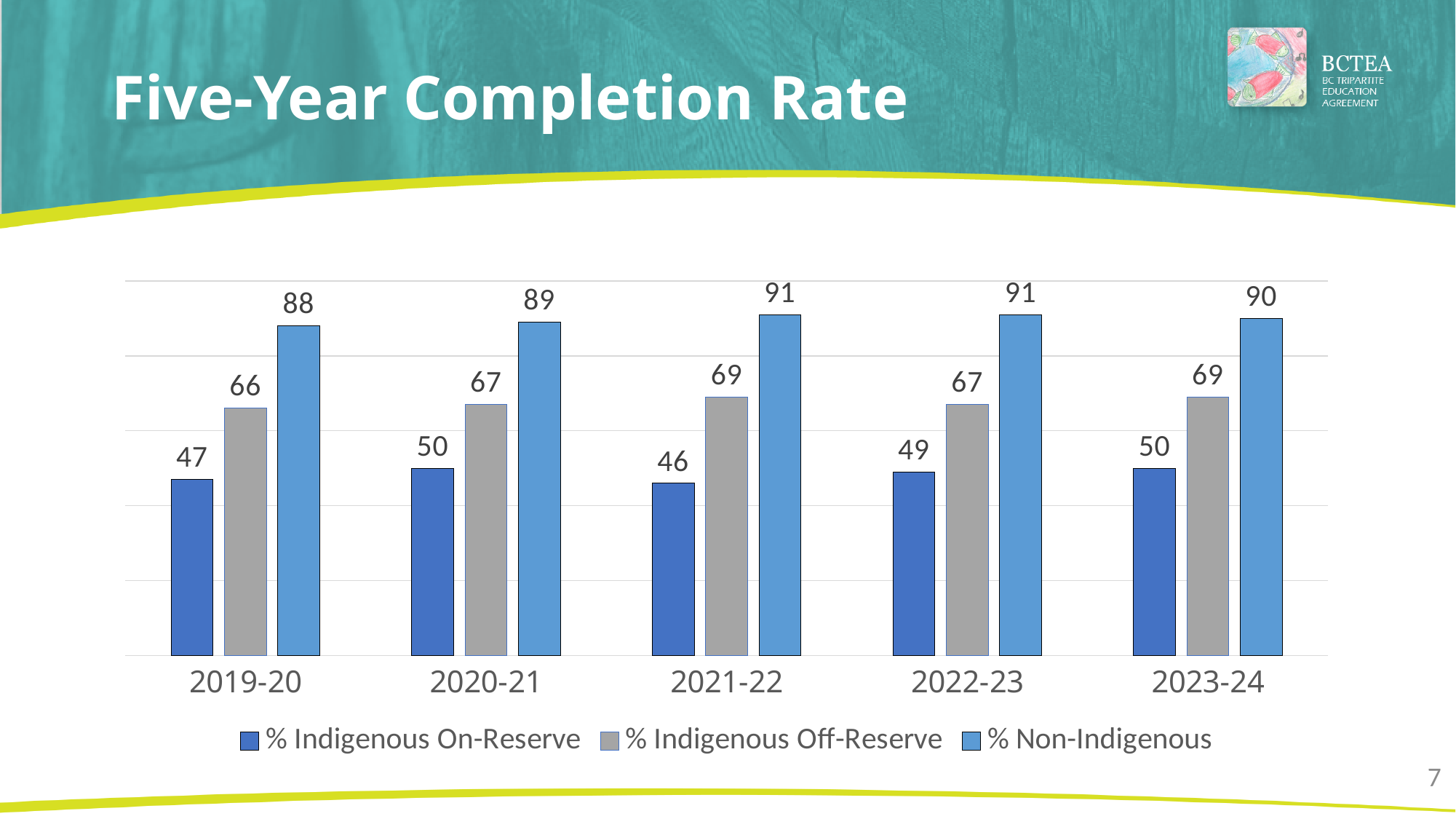
What is the difference between the % Non-Indigenous and % Indigenous On-Reserve values in 2022-23? 42 What is the % Indigenous Off-Reserve value for 2023-24? 69 How many years are shown on the x axis? 5 How many series does the legend list? 3 In which year is the % Indigenous On-Reserve value lowest? 2021-22 What is the difference between the % Indigenous Off-Reserve values in 2021-22 and 2019-20? 3 What is the title of the slide? Five-Year Completion Rate What is the % Indigenous On-Reserve value for 2019-20? 47 In which year is the % Non-Indigenous value lowest? 2019-20 Which is larger: the % Indigenous On-Reserve value in 2020-21 or in 2021-22? 2020-21 What is the % Non-Indigenous value for 2021-22? 91 What kind of chart is shown on the slide? Bar chart